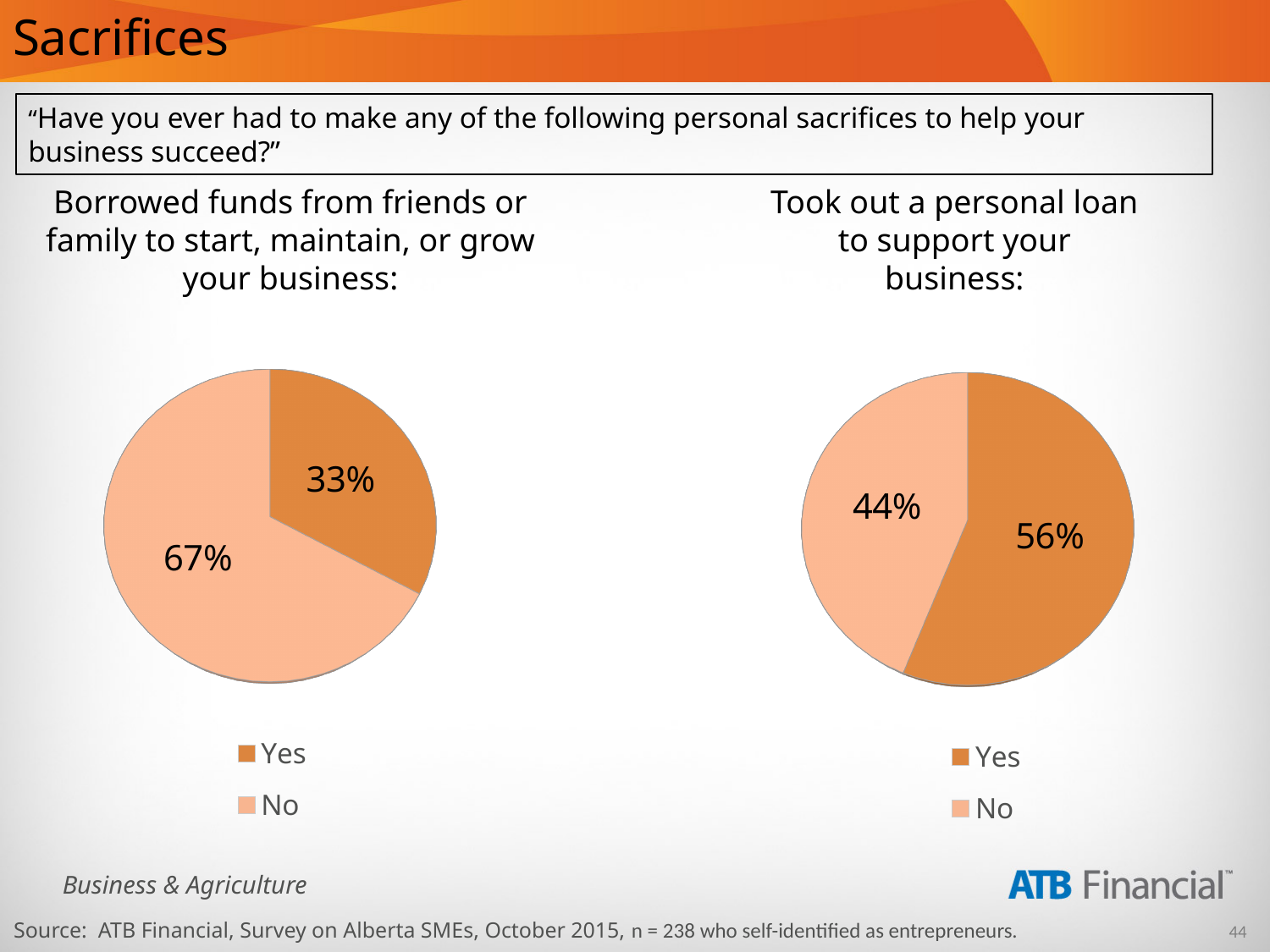
In the left pie chart (Borrowed funds from friends or family), what is the difference between the No and Yes shares? 34 percentage points In the left pie chart (Borrowed funds from friends or family), which response has the larger share? No What are the two legend entries for the left pie chart (Borrowed funds from friends or family)? Yes and No How many slices does the right pie chart (Took out a personal loan) have? 2 In the right pie chart (Took out a personal loan), what is the difference between the Yes and No shares? 12 percentage points What type of chart is used on this slide? Pie chart In the right pie chart (Took out a personal loan), what percentage answered No? 44% In the left pie chart (Borrowed funds from friends or family), what percentage answered No? 67% Is the Yes share larger in the left pie chart (Borrowed funds) or the right pie chart (Personal loan)? Right pie chart (Personal loan) In the right pie chart (Took out a personal loan), what percentage answered Yes? 56% In the left pie chart (Borrowed funds from friends or family), what percentage answered Yes? 33% In the right pie chart (Took out a personal loan), which response has the smaller share? No